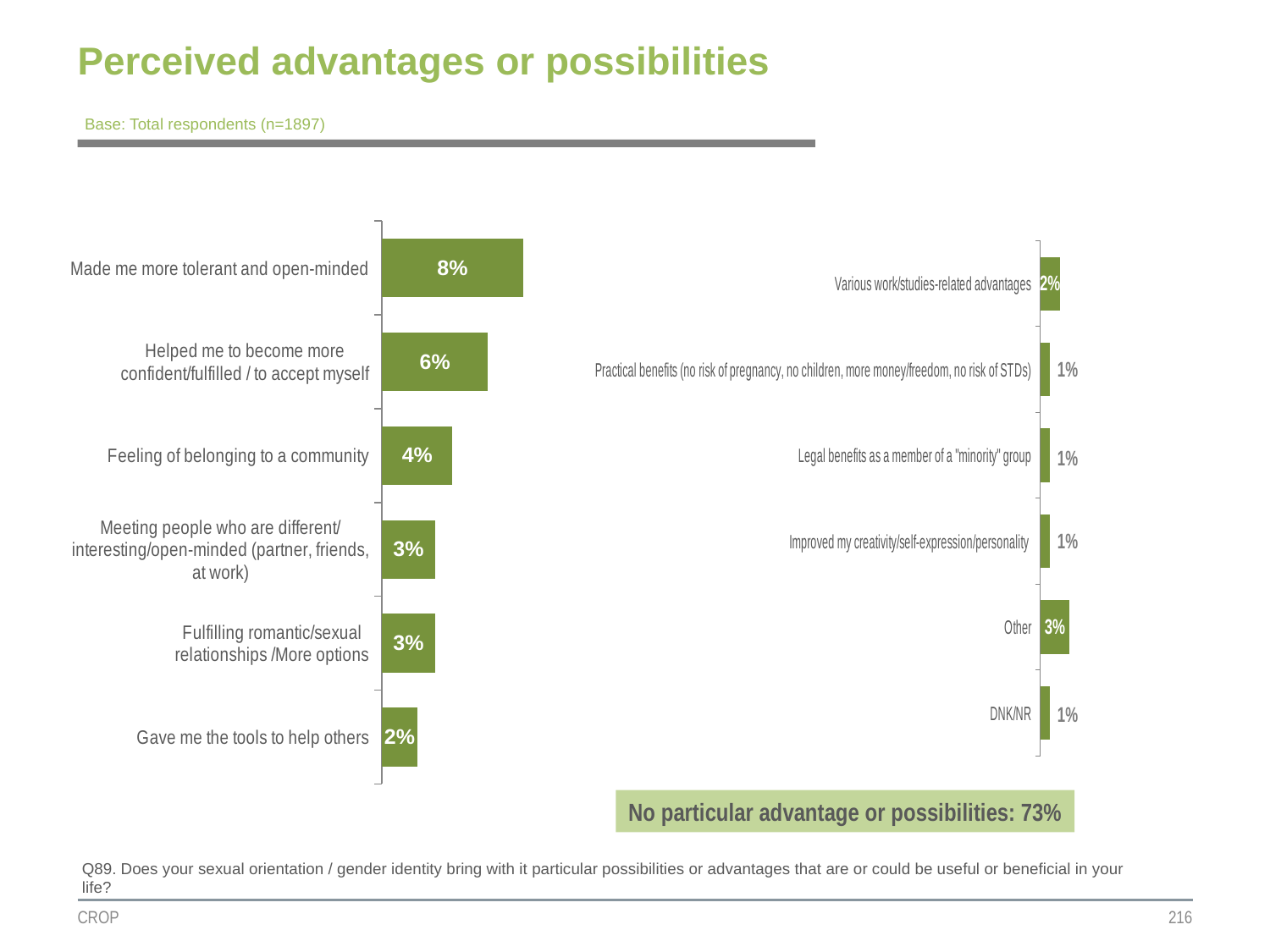
What percentage of respondents reported no particular advantage or possibilities? 73% In the left chart, how many categories are shown? 6 In the right chart, what is the value for 'Various work/studies-related advantages'? 2% In the right chart, which category has the highest value? Other In the right chart, what is the value for 'Other'? 3% In the right chart, how many categories are shown? 6 In the left chart, what is the value for 'Feeling of belonging to a community'? 4% In the left chart, which category has the highest value? Made me more tolerant and open-minded In the left chart, what is the difference between 'Made me more tolerant and open-minded' and 'Helped me to become more confident/fulfilled / to accept myself'? 2% In the left chart, which category has the lowest value? Gave me the tools to help others What type of chart is used on this slide? Bar chart In the left chart, what percentage of respondents said their orientation made them more tolerant and open-minded? 8%